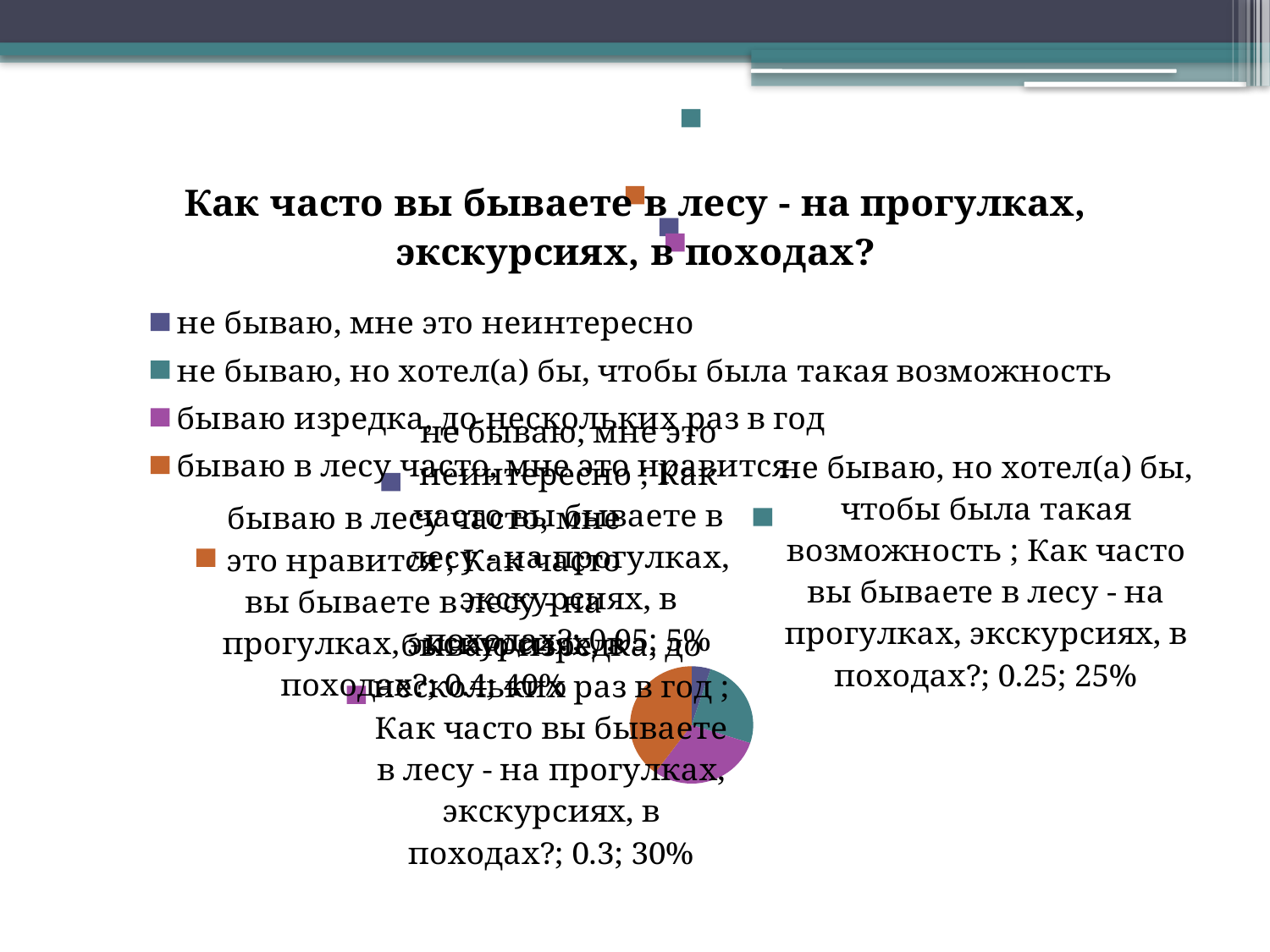
What kind of chart is shown on the slide? pie chart What percentage is shown for "не бываю, мне это неинтересно"? 5% What percentage is shown for "бываю в лесу часто, мне это нравится"? 40% What is the title of the chart? Как часто вы бываете в лесу - на прогулках, экскурсиях, в походах? How many categories does the legend list? 4 Which category has the smallest share of the pie? не бываю, мне это неинтересно What percentage is shown for "бываю изредка, до нескольких раз в год"? 30% What percentage is shown for "не бываю, но хотел(а) бы, чтобы была такая возможность"? 25% Which is larger: the share for "не бываю, но хотел(а) бы, чтобы была такая возможность" or for "бываю изредка, до нескольких раз в год"? бываю изредка, до нескольких раз в год What colour is the slice for "бываю в лесу часто, мне это нравится"? orange Which category has the largest share of the pie? бываю в лесу часто, мне это нравится What is the difference in percentage points between "бываю в лесу часто, мне это нравится" and "бываю изредка, до нескольких раз в год"? 10